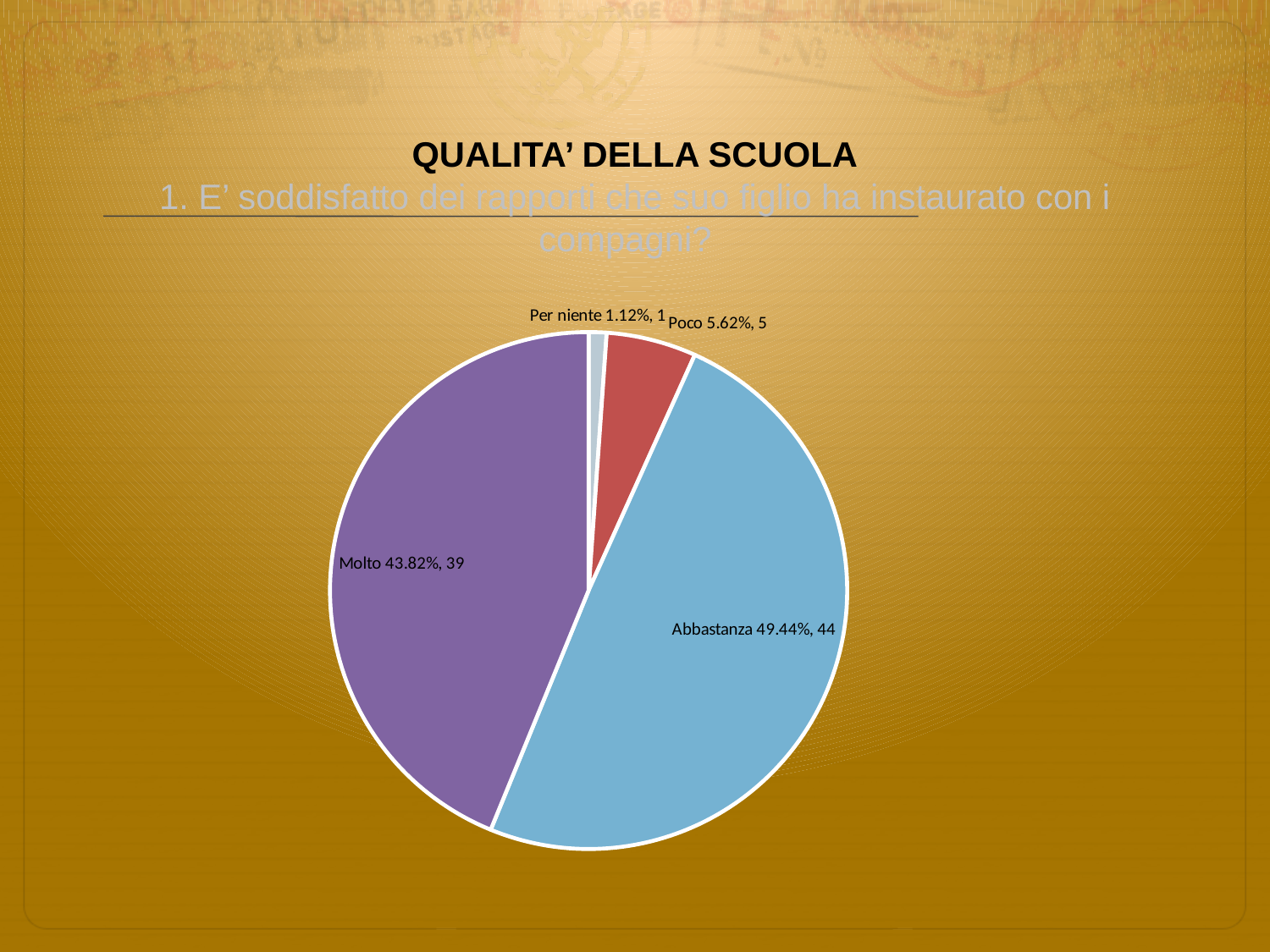
What is the count shown for the Poco slice? 5 What is the total count across all four slices? 89 What kind of chart is shown on the slide? pie chart Which is larger, the Poco slice or the Per niente slice? Poco What colour is the Molto slice? purple What percentage share does the Molto slice have? 43.82% Which category has the smallest slice of the pie? Per niente How many slices does the pie chart have? 4 What is the count shown for the Per niente slice? 1 What is the difference in count between Abbastanza and Molto? 5 Which category has the largest slice of the pie? Abbastanza What percentage share does the Abbastanza slice have? 49.44%